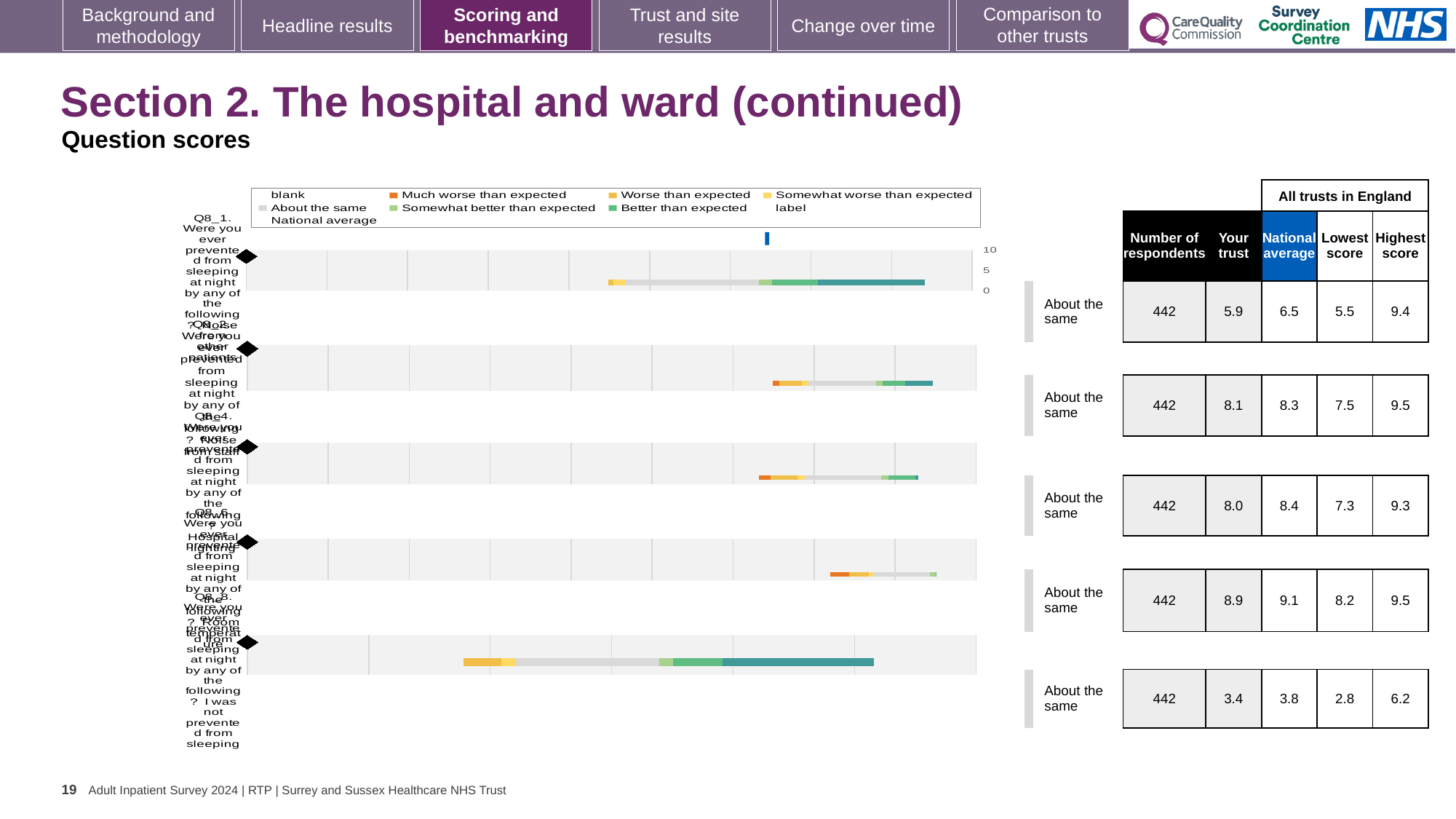
In the table beside the chart, which row has the lowest 'Your trust' score? Q8_8 (last row), 3.4 In the table beside the chart, which row has the highest 'Your trust' score? Q8_6 (fourth row), 9.1 In the table beside the chart, what is the 'Your trust' score for the first row (Q8_1)? 5.9 What benchmark label is shown next to every bar in the chart? About the same What kind of chart is shown on the slide? bar chart How many question rows (bars) does the chart show? 5 In the table beside the chart, how many respondents are listed for each row? 442 In the table beside the chart, what is the highest score across all trusts in England for the third row (Q8_4)? 9.3 Which legend entry is shown in dark orange in the chart legend? Much worse than expected In the table beside the chart, what is the national average for the last row (Q8_8)? 3.8 In the table beside the chart, is the 'Your trust' score for the second row (Q8_2) larger or smaller than the national average? smaller In the table beside the chart, what is the difference between the national average and 'Your trust' score for the first row (Q8_1)? 0.6